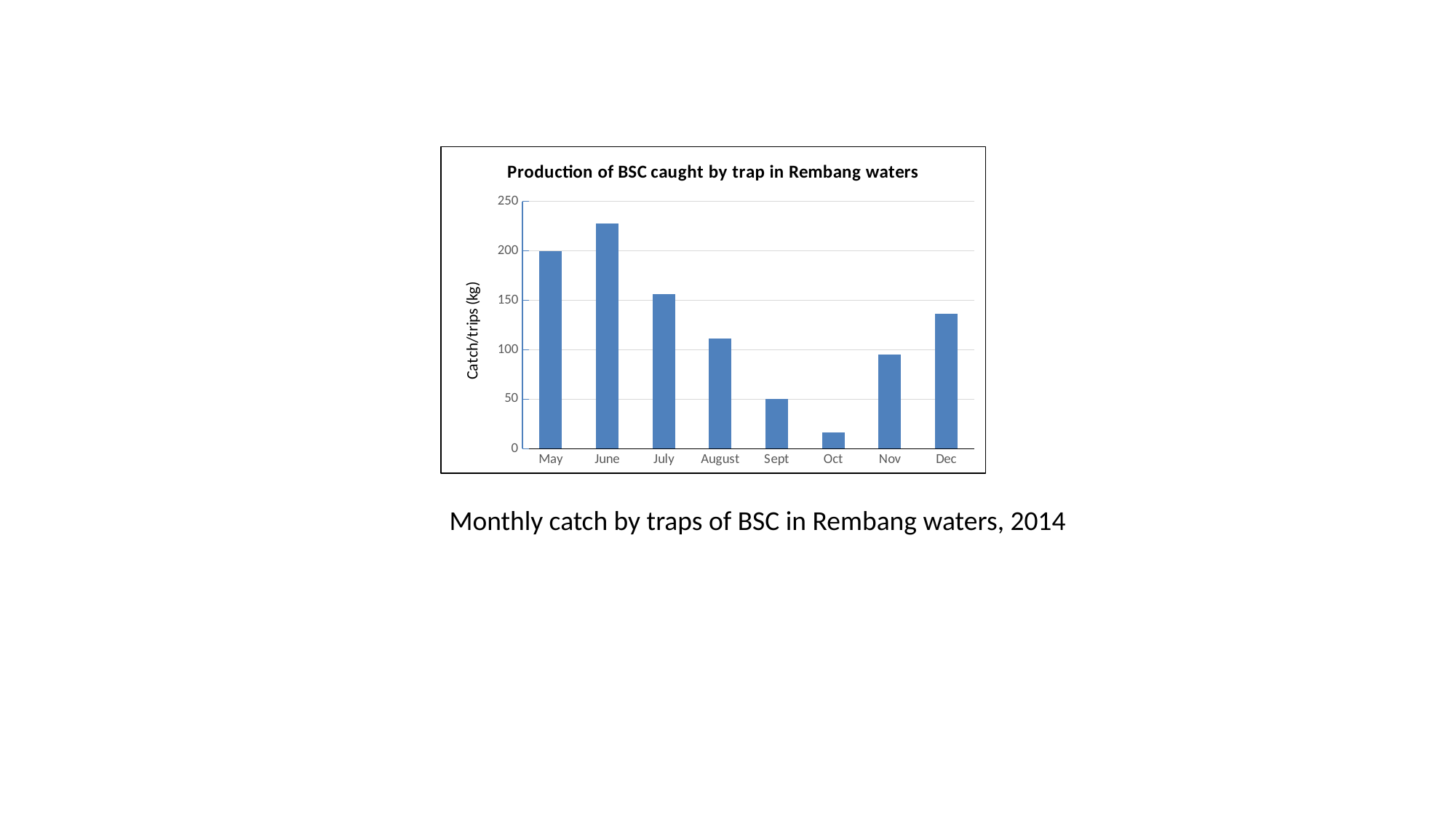
What kind of chart is shown on the slide? bar chart What is the label on the y axis of the chart? Catch/trips (kg) Which month has the highest catch per trip? June Which month has a higher catch per trip, Nov or Dec? Dec How many months are shown on the x axis? 8 Is the value for Nov greater or less than 100? less Which month has a higher catch per trip, May or July? May Do the values rise or fall from June to Oct? fall Is the value for August greater or less than 100? greater Is the value for June greater or less than 200? greater Which month has the lowest catch per trip? Oct